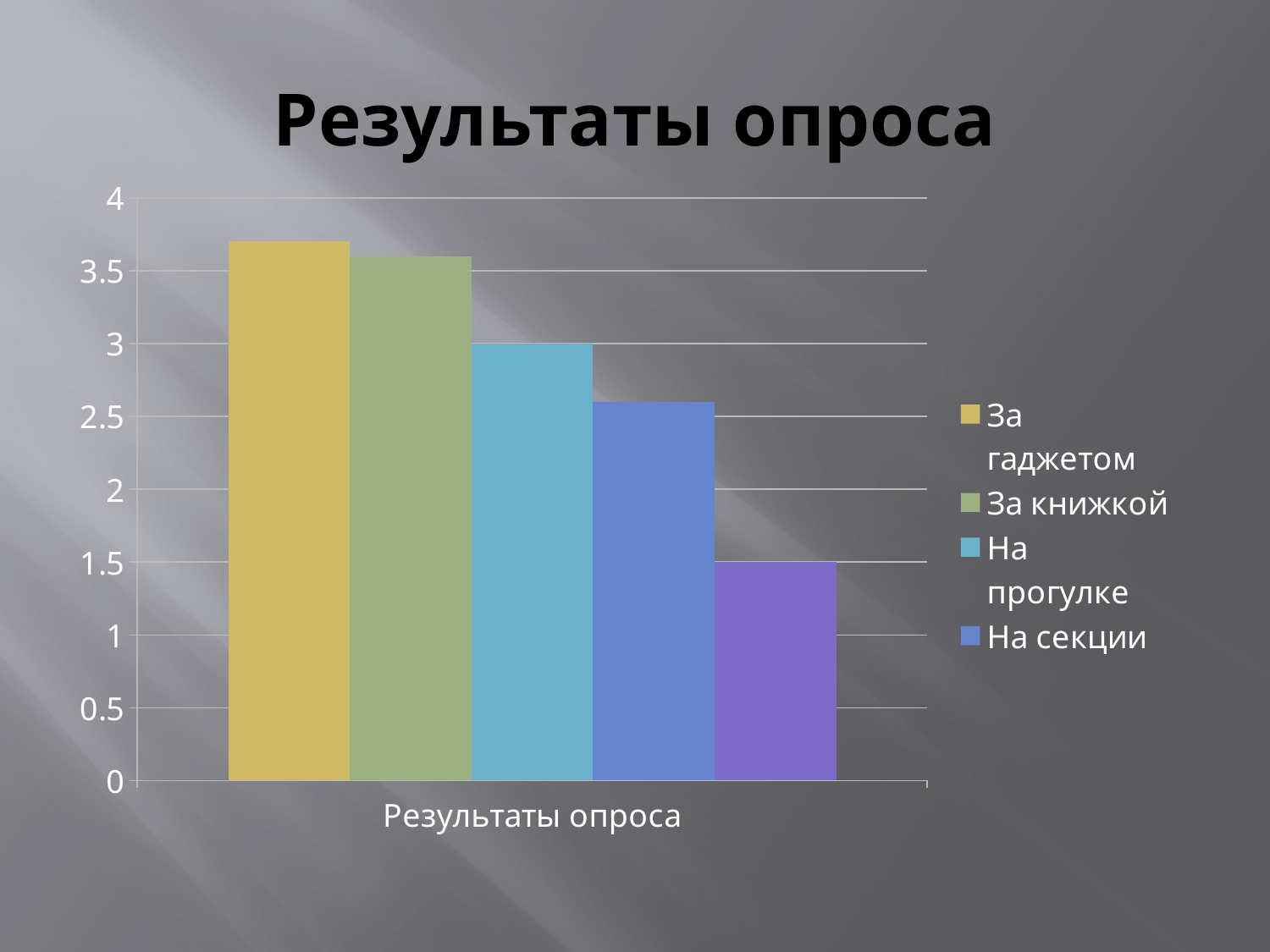
Which is larger, На прогулке or На секции? На прогулке Which is larger, За гаджетом or На прогулке? За гаджетом Which is larger, За книжкой or На секции? За книжкой How many series does the legend list? 4 Is the value for За книжкой greater or less than 3? greater What is the value for На прогулке? 3 What kind of chart is shown on the slide? bar chart What is the title of the chart? Результаты опроса What colour is the bar for За гаджетом? yellow How many bars are plotted in the chart? 5 Is the value for На секции greater or less than 3? less Is the value for За гаджетом greater or less than 3.5? greater